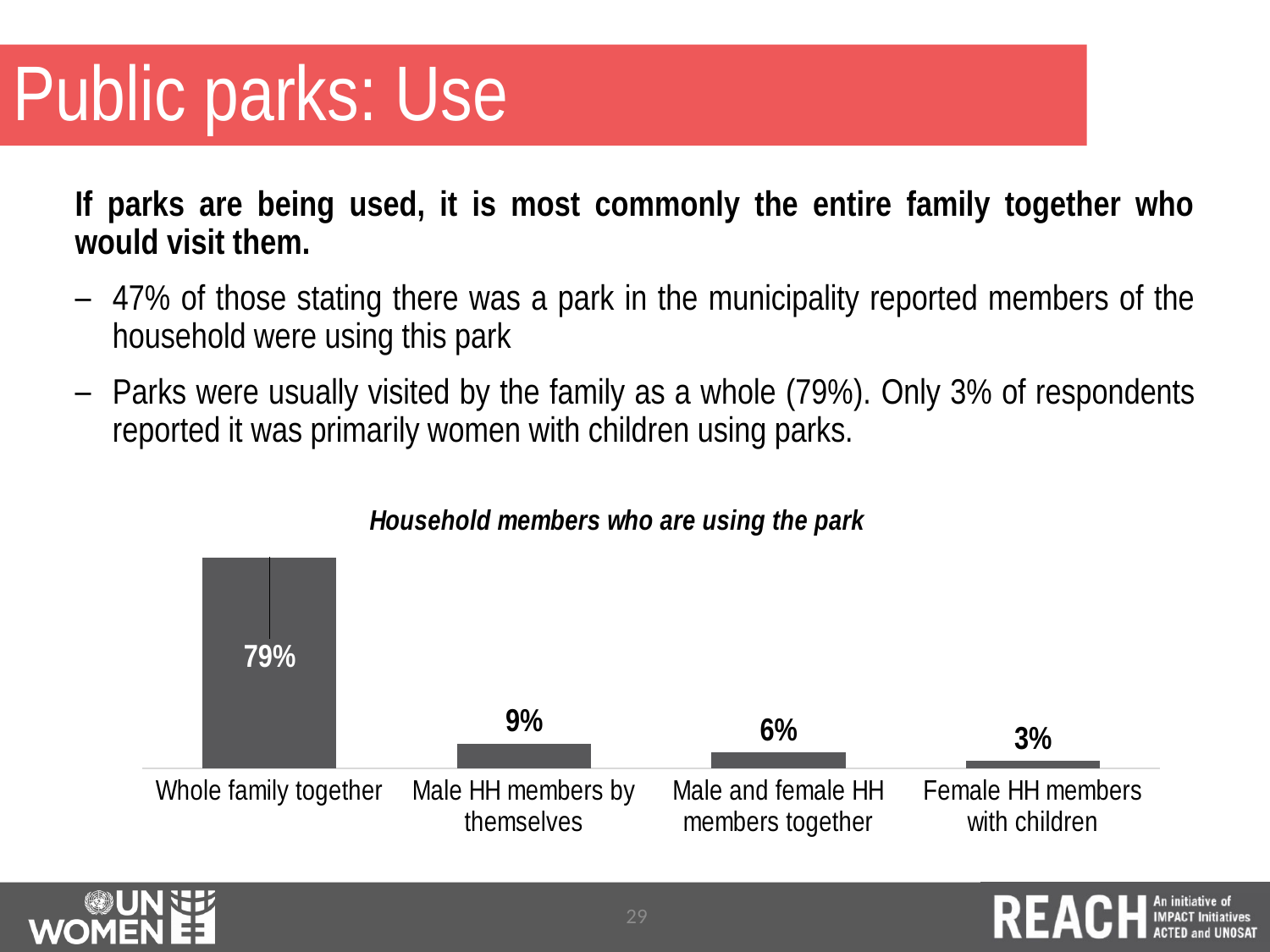
Which is larger, Male HH members by themselves or Male and female HH members together? Male HH members by themselves What is the title of the chart? Household members who are using the park How many categories are shown in the chart? 4 Which category has the lowest value? Female HH members with children What is the difference between Male and female HH members together and Female HH members with children? 3% What is the value for Whole family together? 79% What kind of chart is shown on the slide? Bar chart Which category has the highest value? Whole family together What is the difference between Whole family together and Male HH members by themselves? 70% What is the value for Male HH members by themselves? 9% What is the value for Female HH members with children? 3% What is the value for Male and female HH members together? 6%